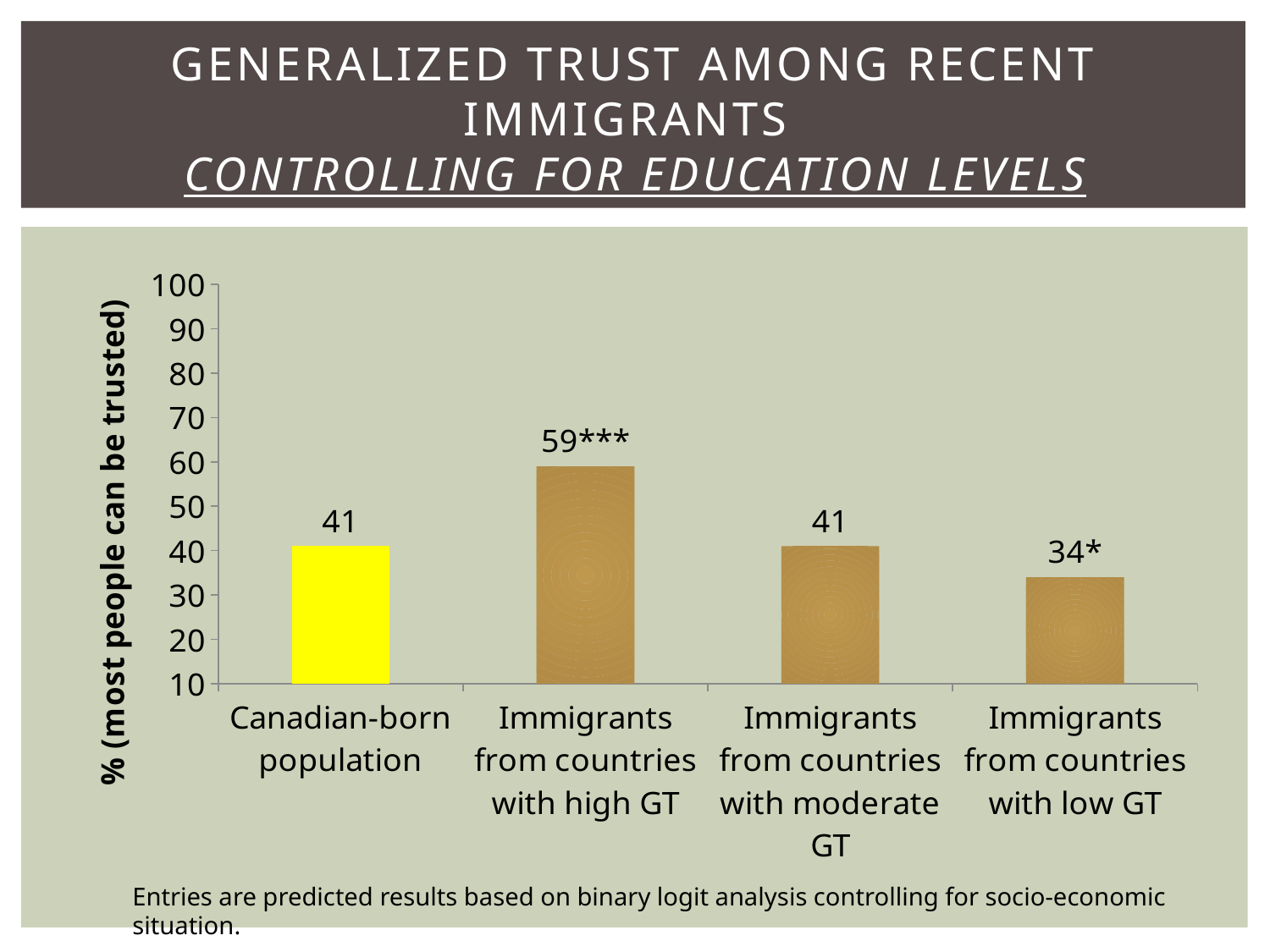
What is the difference between the value for immigrants from countries with high GT and the Canadian-born population? 18 What kind of chart is shown on the slide? Bar chart Which category has the highest value? Immigrants from countries with high GT What is the data label shown for immigrants from countries with high GT? 59*** What is the value for the Canadian-born population? 41 How many categories are shown on the x axis? 4 What is the data label shown for immigrants from countries with low GT? 34* Which category has the lowest value? Immigrants from countries with low GT What is the value for immigrants from countries with moderate GT? 41 Which is larger: the value for immigrants from countries with high GT or immigrants from countries with low GT? Immigrants from countries with high GT What is the difference between the value for immigrants from countries with moderate GT and immigrants from countries with low GT? 7 What is the y-axis label of the chart? % (most people can be trusted)